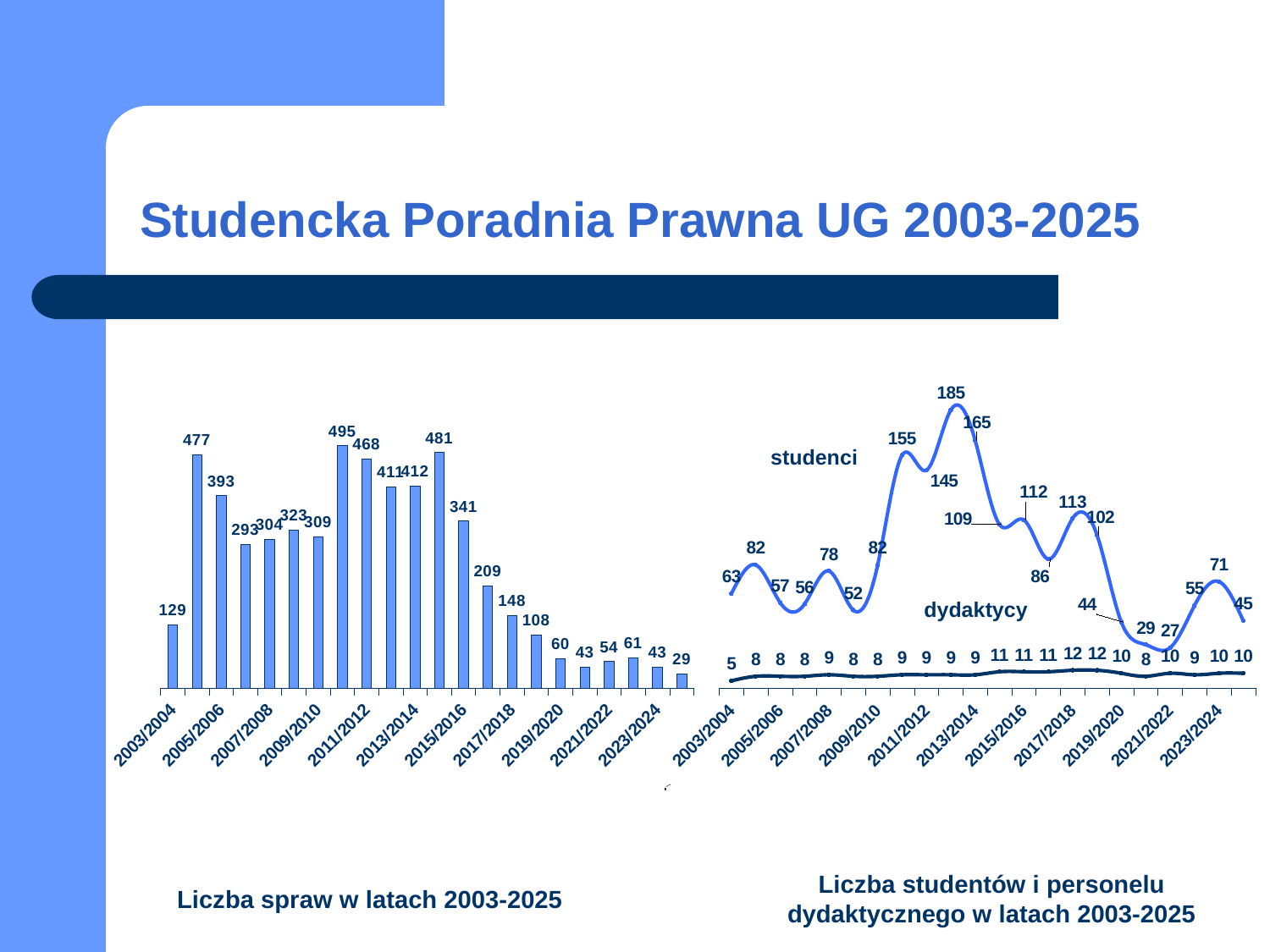
In the chart 'Liczba spraw w latach 2003-2025', what is the lowest value shown? 29 In the chart 'Liczba spraw w latach 2003-2025', what is the highest value shown? 495 In the chart 'Liczba studentów i personelu dydaktycznego w latach 2003-2025', what is the lowest value of the 'studenci' series? 27 In the chart 'Liczba spraw w latach 2003-2025', what is the difference between the highest and lowest values? 466 In the chart 'Liczba studentów i personelu dydaktycznego w latach 2003-2025', what is the value of 'dydaktycy' for 2003/2004? 5 What kind of chart is 'Liczba spraw w latach 2003-2025'? bar chart What kind of chart is 'Liczba studentów i personelu dydaktycznego w latach 2003-2025'? line chart In the chart 'Liczba studentów i personelu dydaktycznego w latach 2003-2025', which series has the larger value for 2003/2004, 'studenci' or 'dydaktycy'? studenci How many series are plotted in the chart 'Liczba studentów i personelu dydaktycznego w latach 2003-2025'? 2 In the chart 'Liczba spraw w latach 2003-2025', what is the value for 2003/2004? 129 How many bars are plotted in the chart 'Liczba spraw w latach 2003-2025'? 22 In the chart 'Liczba studentów i personelu dydaktycznego w latach 2003-2025', what is the highest value of the 'studenci' series? 185